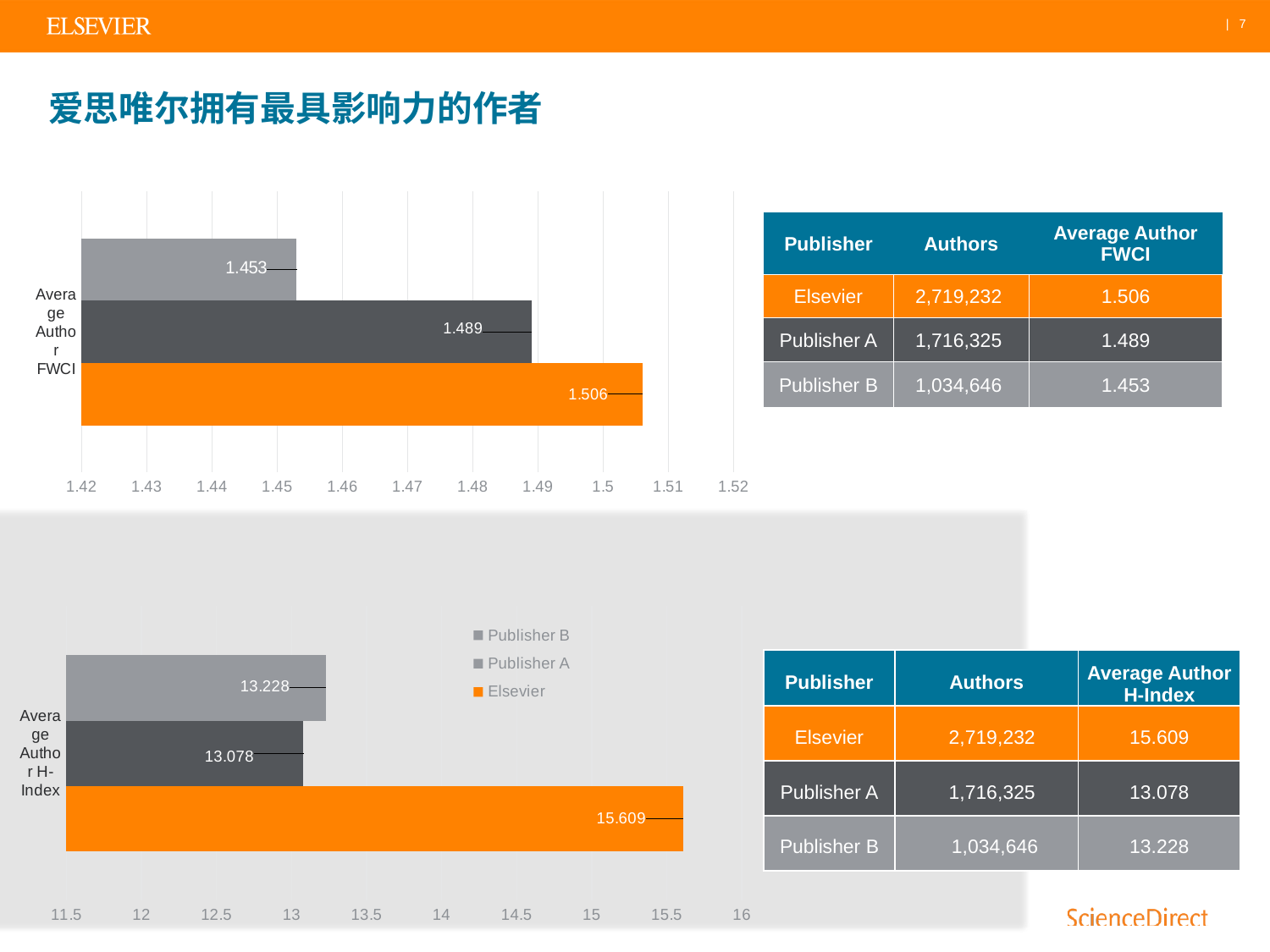
In the top chart (Average Author FWCI), what is the difference between Elsevier's value and Publisher A's value? 0.017 In the bottom chart (Average Author H-Index), which colour represents Elsevier? Orange How many series does the legend of the bottom chart (Average Author H-Index) list? 3 In the top chart (Average Author FWCI), which publisher has the lowest value? Publisher B In the top chart (Average Author FWCI), what is the value for Elsevier? 1.506 In the bottom chart (Average Author H-Index), what is the value for Publisher A? 13.078 In the top chart (Average Author FWCI), what is the value for Publisher B? 1.453 In the bottom chart (Average Author H-Index), what is the value for Elsevier? 15.609 What type of chart is the bottom chart (Average Author H-Index)? Bar chart In the bottom chart (Average Author H-Index), what is the difference between Elsevier's value and Publisher B's value? 2.381 In the bottom chart (Average Author H-Index), which is larger, the value for Publisher A or Publisher B? Publisher B In the top chart (Average Author FWCI), which publisher has the highest value? Elsevier